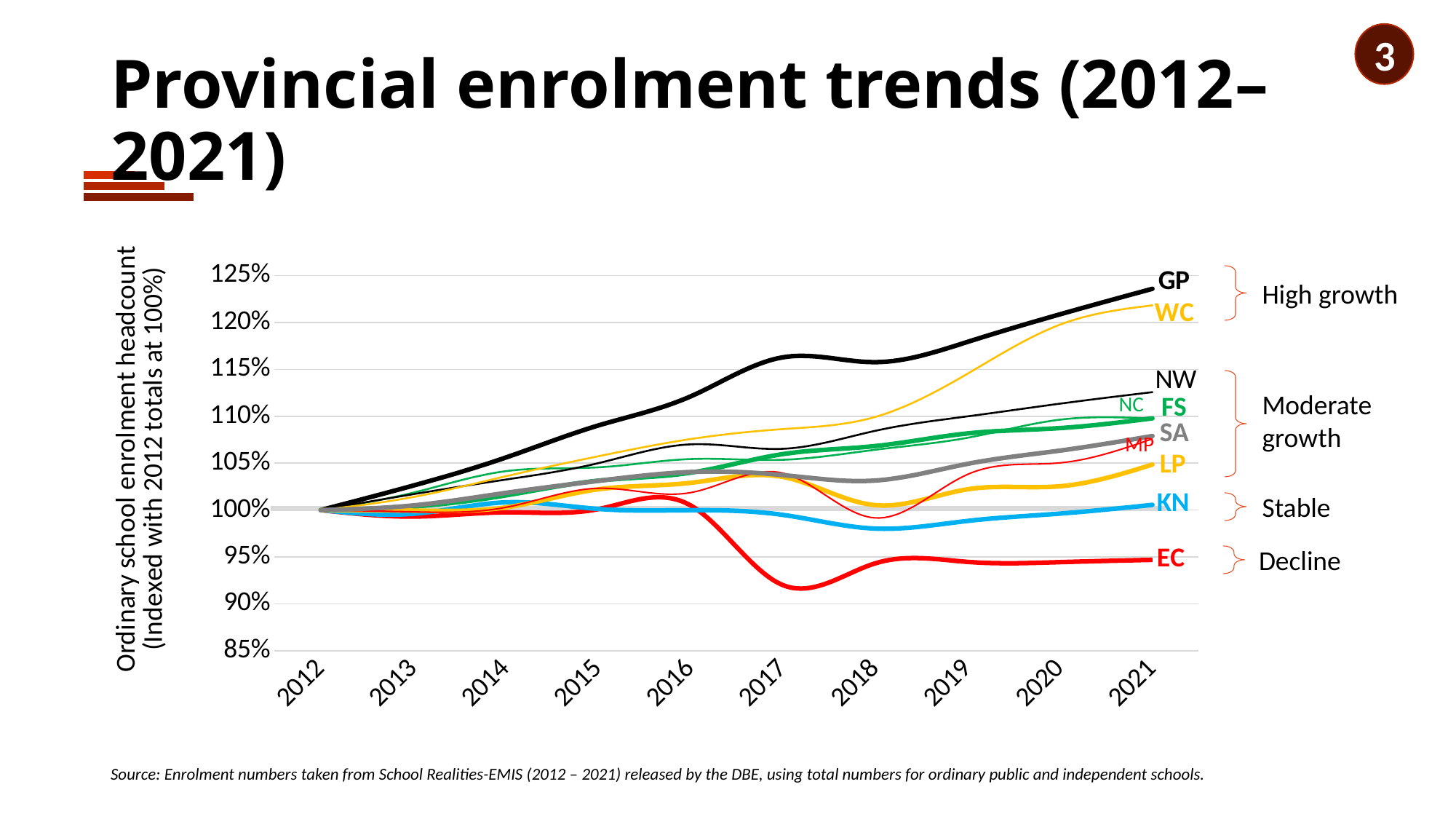
What is the indexed value for GP in 2012? 100% In 2021, which is larger: the value for KN or the value for EC? KN Which growth category label is given to the GP and WC lines? High growth How many years are shown along the x axis of the chart? 10 How many labelled lines (series) does the chart show? 10 Which province has the highest indexed enrolment in 2021? GP Is the value for KN in 2018 greater or less than 100%? less Which province has the lowest indexed enrolment in 2021? EC Does the EC line rise or fall overall from 2012 to 2021? fall What kind of chart is shown on the slide? line chart Is the value for EC in 2017 greater or less than 95%? less Is the value for GP in 2021 greater or less than 120%? greater